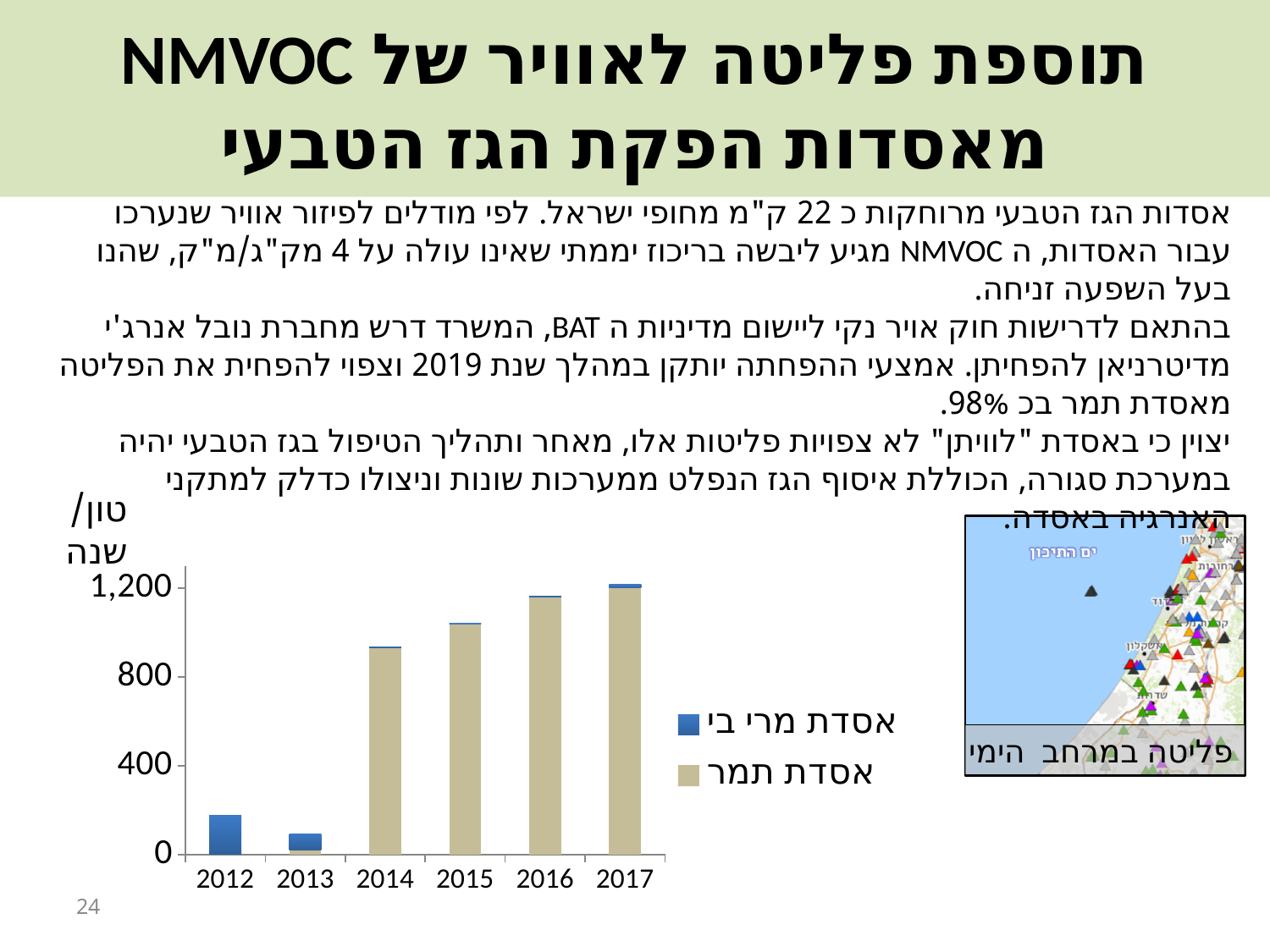
Is the total value for 2014 greater or less than 800? greater Which year has a larger total emission, 2012 or 2014? 2014 What kind of chart is shown on the slide? bar chart Is the total value for 2012 greater or less than 400? less Which series accounts for the entire bar in 2012? אסדת מרי בי Do the total emissions rise or fall from 2014 to 2017? rise Which year has the lowest total emission in the chart? 2013 Is the total value for 2016 greater or less than 1,200? less What unit is written above the y axis of the chart? טון/שנה How many years are shown on the x axis of the chart? 6 How many series does the chart legend list? 2 Which year has the highest total emission in the chart? 2017